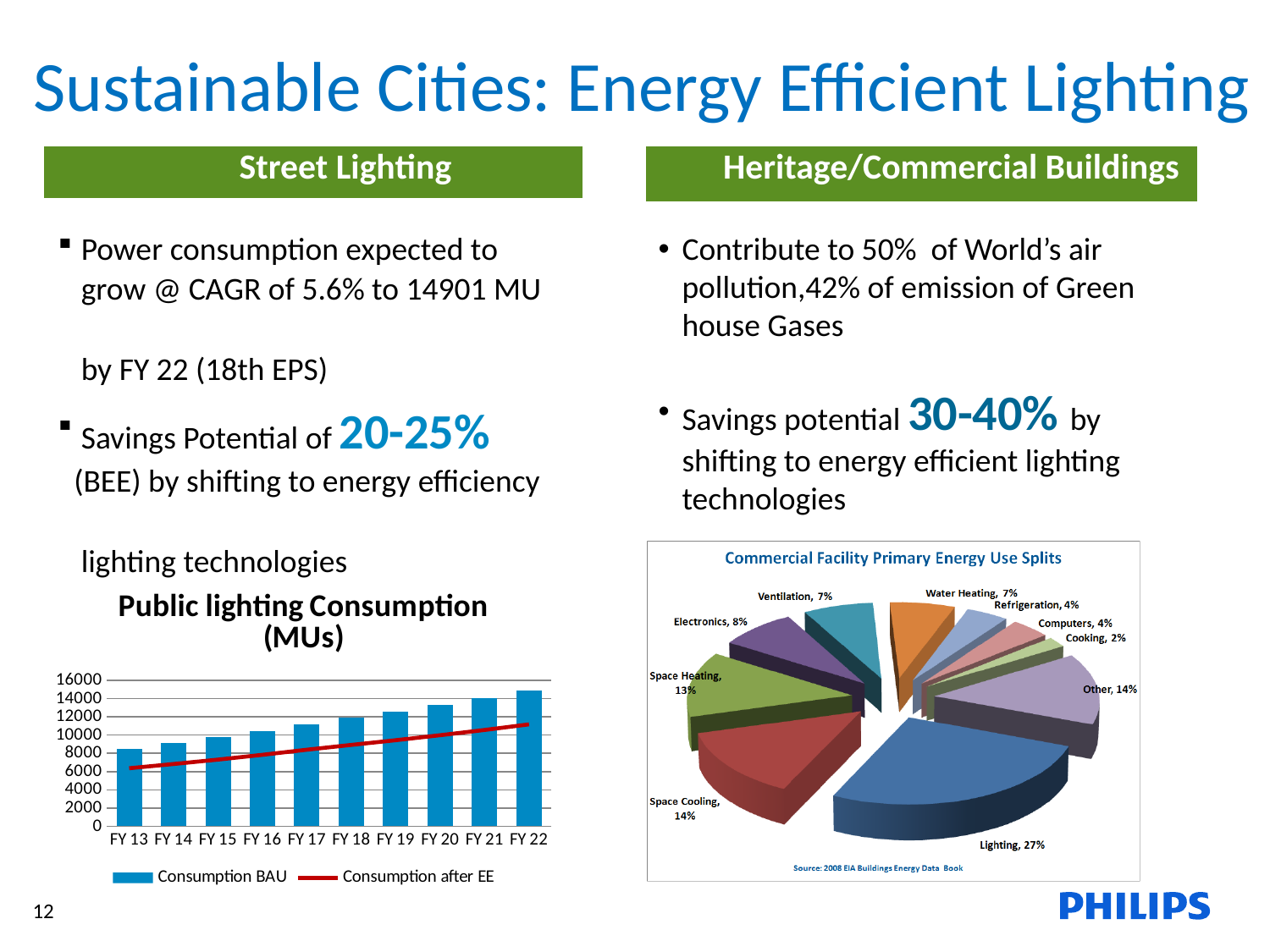
In the Public lighting Consumption (MUs) chart, what kind of chart is used for the Consumption BAU series? Bar chart In the Public lighting Consumption (MUs) chart, does Consumption BAU rise or fall from FY 13 to FY 22? Rise In the Public lighting Consumption (MUs) chart, how many series does the legend list? 2 In the Commercial Facility Primary Energy Use Splits pie chart, how many categories are shown? 10 In the Commercial Facility Primary Energy Use Splits pie chart, which category has the smallest share? Cooking In the Commercial Facility Primary Energy Use Splits pie chart, what share does Lighting have? 27% In the Public lighting Consumption (MUs) chart, which fiscal year has the highest Consumption BAU? FY 22 In the Public lighting Consumption (MUs) chart, how many fiscal years are shown on the x axis? 10 In the Commercial Facility Primary Energy Use Splits pie chart, which is larger, Electronics or Ventilation? Electronics In the Public lighting Consumption (MUs) chart, is the Consumption BAU value for FY 22 greater or less than 14000? greater In the Commercial Facility Primary Energy Use Splits pie chart, what is the difference between the Lighting share and the Space Heating share? 14% In the Public lighting Consumption (MUs) chart, is the Consumption BAU value for FY 15 greater or less than 10000? less